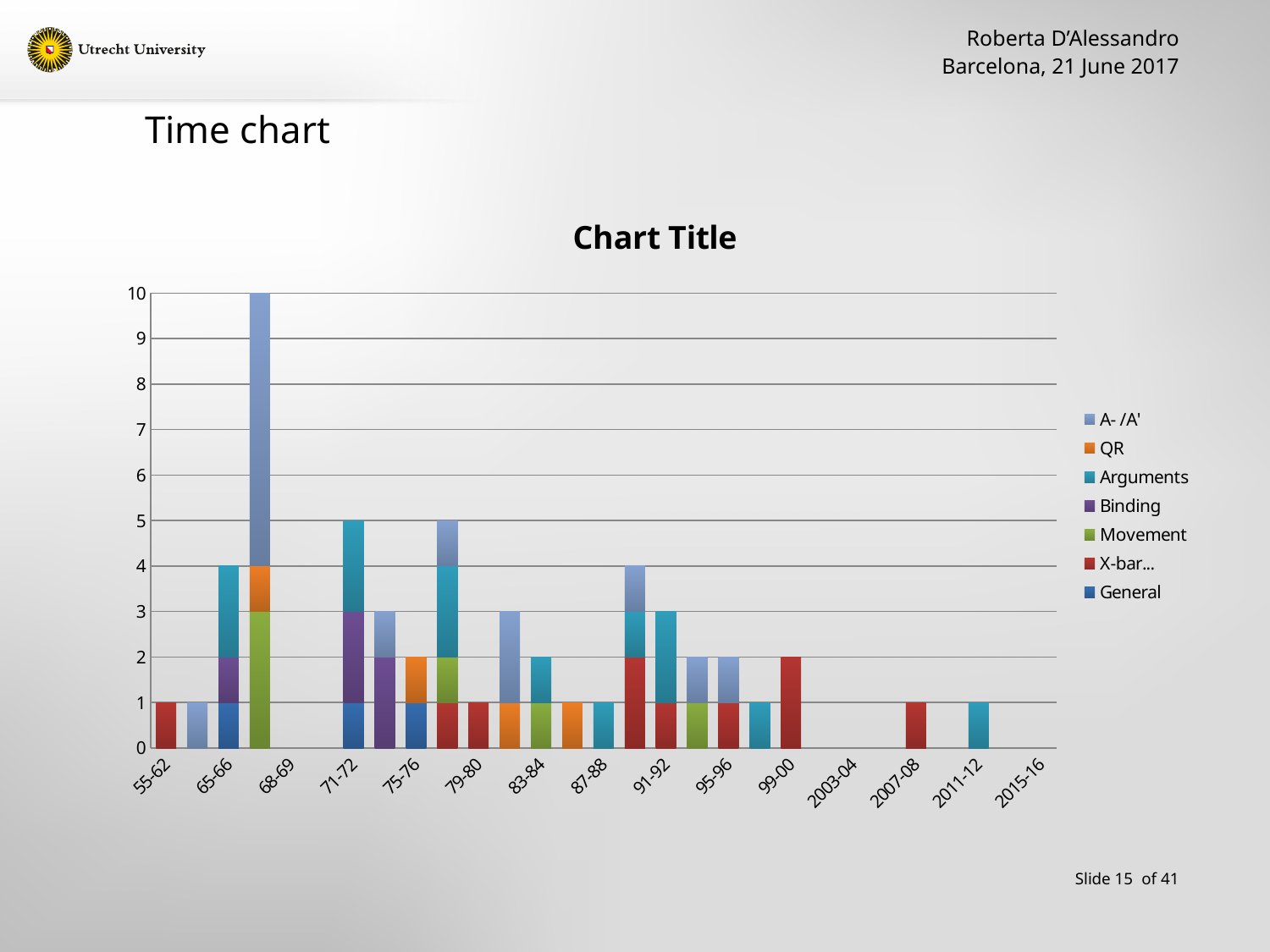
Is the total for 65-66 larger or smaller than the total for 71-72? smaller What is the total height of the stacked bar for 71-72? 5 Is the tallest stacked bar greater or less than 9? greater What is the title of the chart? Chart Title How many category labels are shown on the x axis? 15 How many series does the legend list? 7 Which series does the bar for 2011-12 belong to? Arguments Which series does the bar for 2007-08 belong to? X-bar... What is the total height of the stacked bar for 65-66? 4 What kind of chart is shown on the slide? Stacked bar chart Which series is listed first in the legend? A- /A' What is the highest value shown on the vertical axis? 10